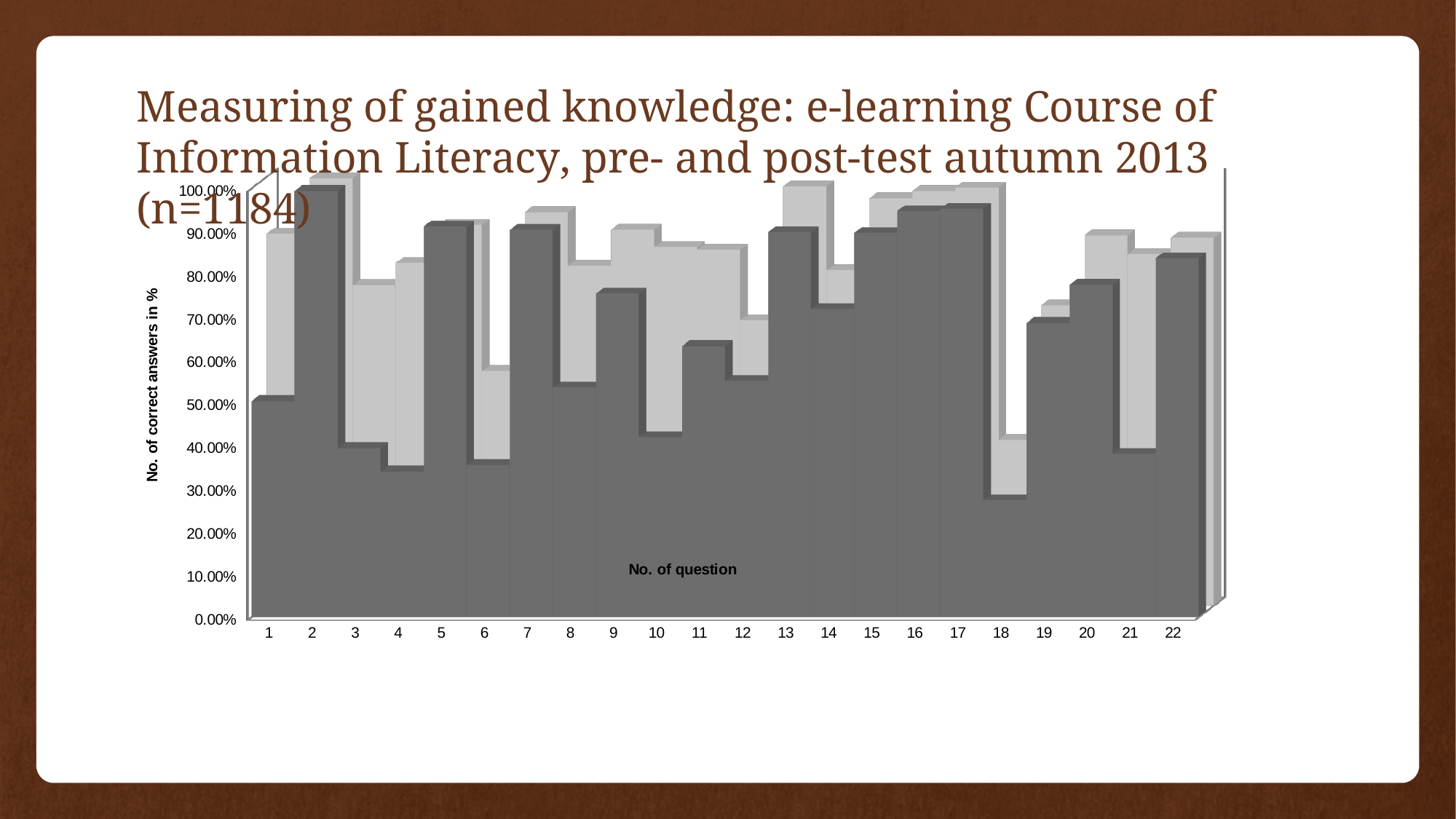
Is the dark gray (front) bar for question 10 greater or less than 50.00%? less Which is larger for the dark gray (front) series: question 17 or question 18? question 17 Which question has the lowest dark gray (front) bar? 18 Is the dark gray (front) bar for question 4 greater or less than 40.00%? less What is the title of the vertical axis of the chart? No. of correct answers in % Is the dark gray (front) bar for question 2 greater or less than 90.00%? greater Which is larger for the dark gray (front) series: question 1 or question 2? question 2 What kind of chart is shown on the slide? bar chart What is the title of the horizontal axis of the chart? No. of question How many questions (categories) are shown along the x axis of the chart? 22